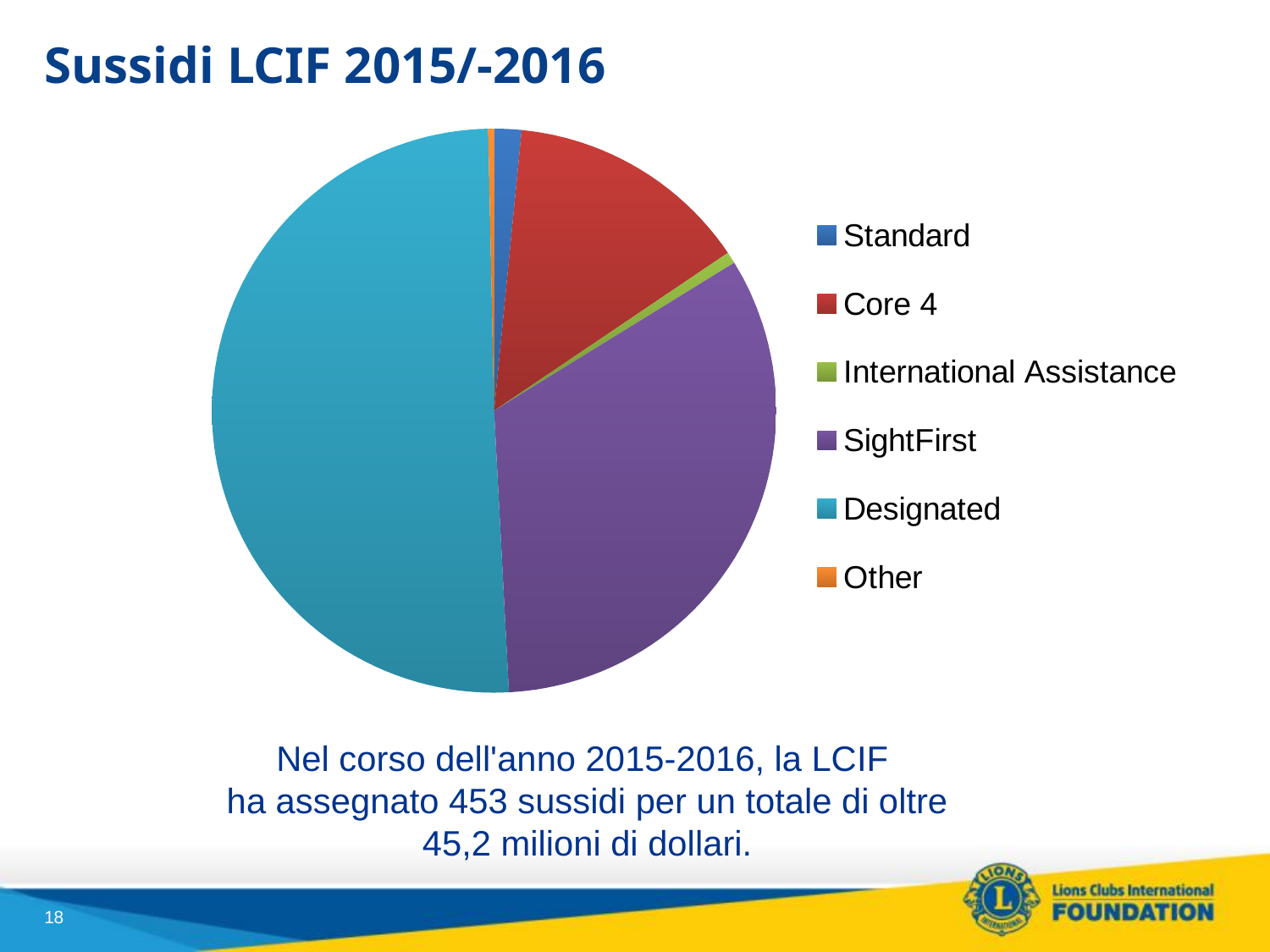
Which category is shown in purple in the pie chart? SightFirst Which slice is larger, Standard or Other? Standard Which slice is larger, SightFirst or Core 4? SightFirst What kind of chart is shown on the slide? pie chart Which slice is larger, Core 4 or International Assistance? Core 4 Which category has the largest slice of the pie chart? Designated How many categories does the legend of the pie chart list? 6 What is the title of the slide containing the pie chart? Sussidi LCIF 2015/-2016